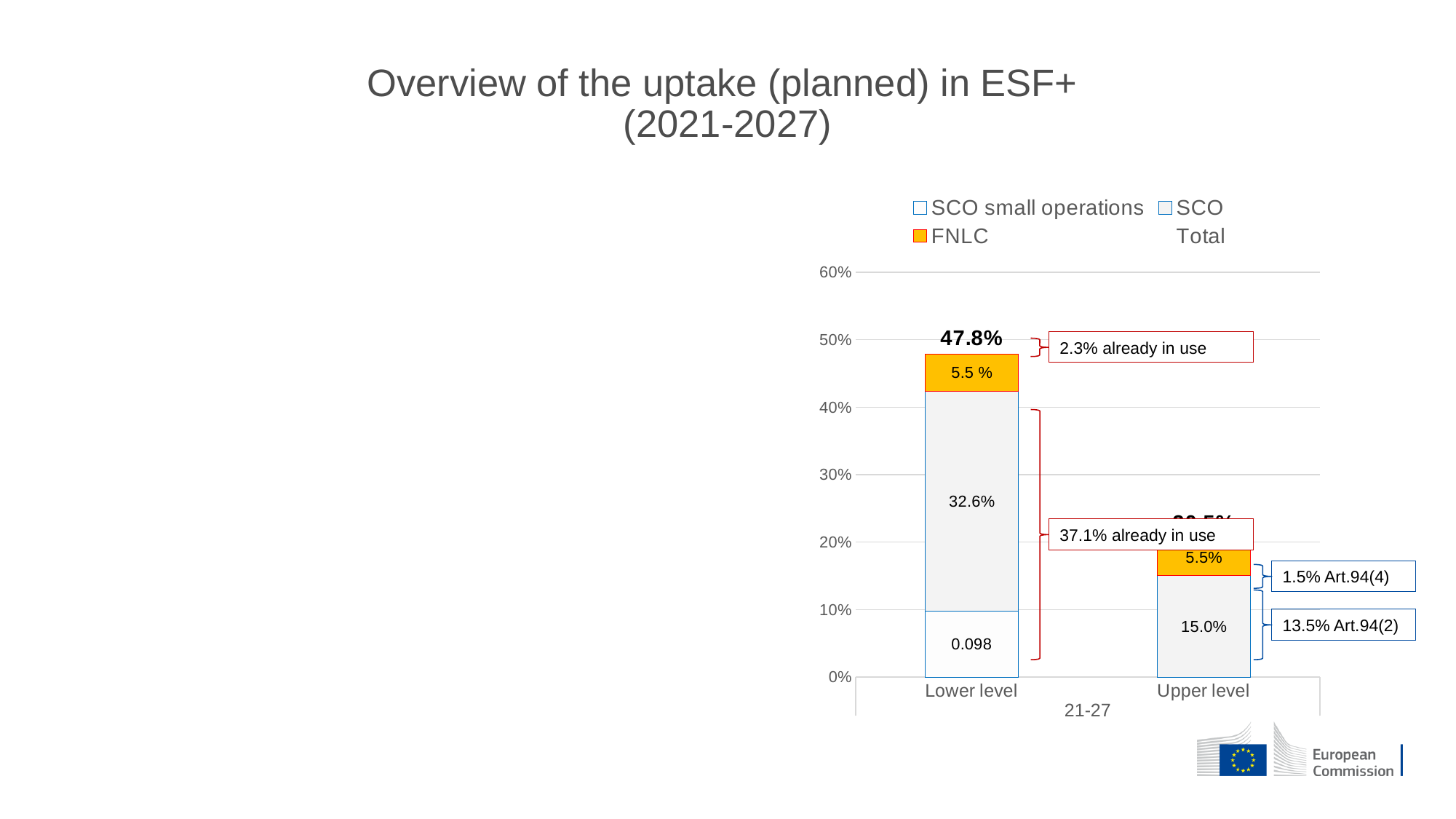
What is the difference between the SCO segment for Lower level and the SCO segment for Upper level? 17.6% What is the value of the SCO segment for Upper level? 15.0% Is the SCO segment for Lower level larger or smaller than the SCO segment for Upper level? larger Which category has the taller stacked bar, Lower level or Upper level? Lower level What type of chart is shown on the slide? stacked bar chart What is the value of the FNLC segment for Lower level? 5.5 % What is the value of the FNLC segment for Upper level? 5.5% How many categories are shown on the x axis? 2 What value is printed on the bottom segment of the Lower level bar? 0.098 What does the callout next to the top of the Lower level bar say? 2.3% already in use What is the value of the SCO segment for Lower level? 32.6% What is the total value labelled above the Lower level bar? 47.8%